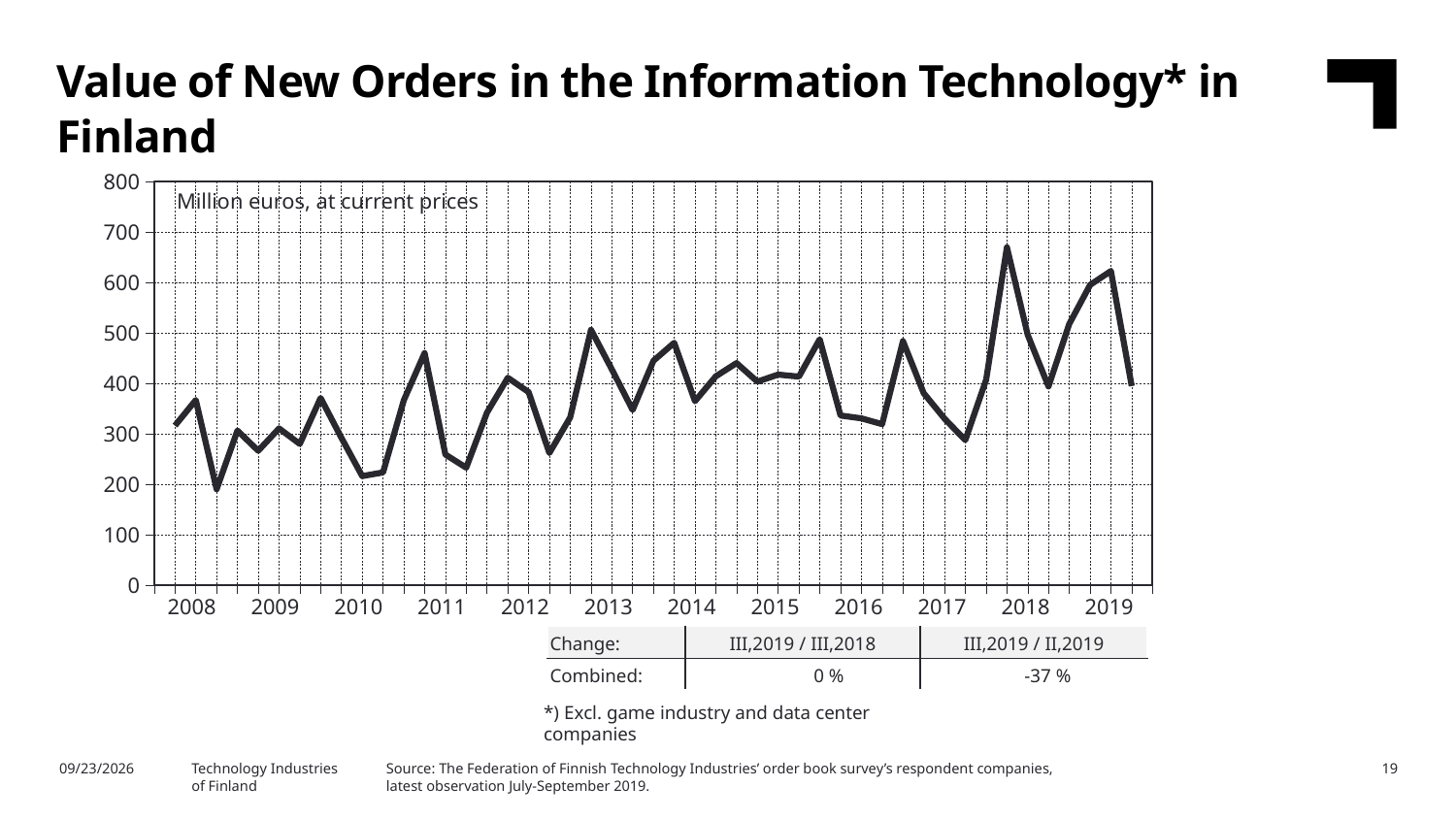
Which is higher: the peak of the line in 2018 or the peak in 2019? 2018 Is the lowest point on the line, in 2008, greater or less than 250? less In which year does the line reach its highest value? 2018 What unit is the chart's data measured in, according to the label inside the plot area? Million euros, at current prices According to the table below the chart, what is the combined change for III,2019 / II,2019? -37 % Is the highest point on the line, reached in 2018, greater or less than 600? greater How many years are labeled on the x axis? 12 Is the low point of the line in 2010 greater or less than 300? less What is the title of the chart on the slide? Value of New Orders in the Information Technology* in Finland According to the table below the chart, what is the combined change for III,2019 / III,2018? 0 % What type of chart is shown on the slide? line chart Does the line rise or fall between the low point in 2017 and the peak in 2018? rise